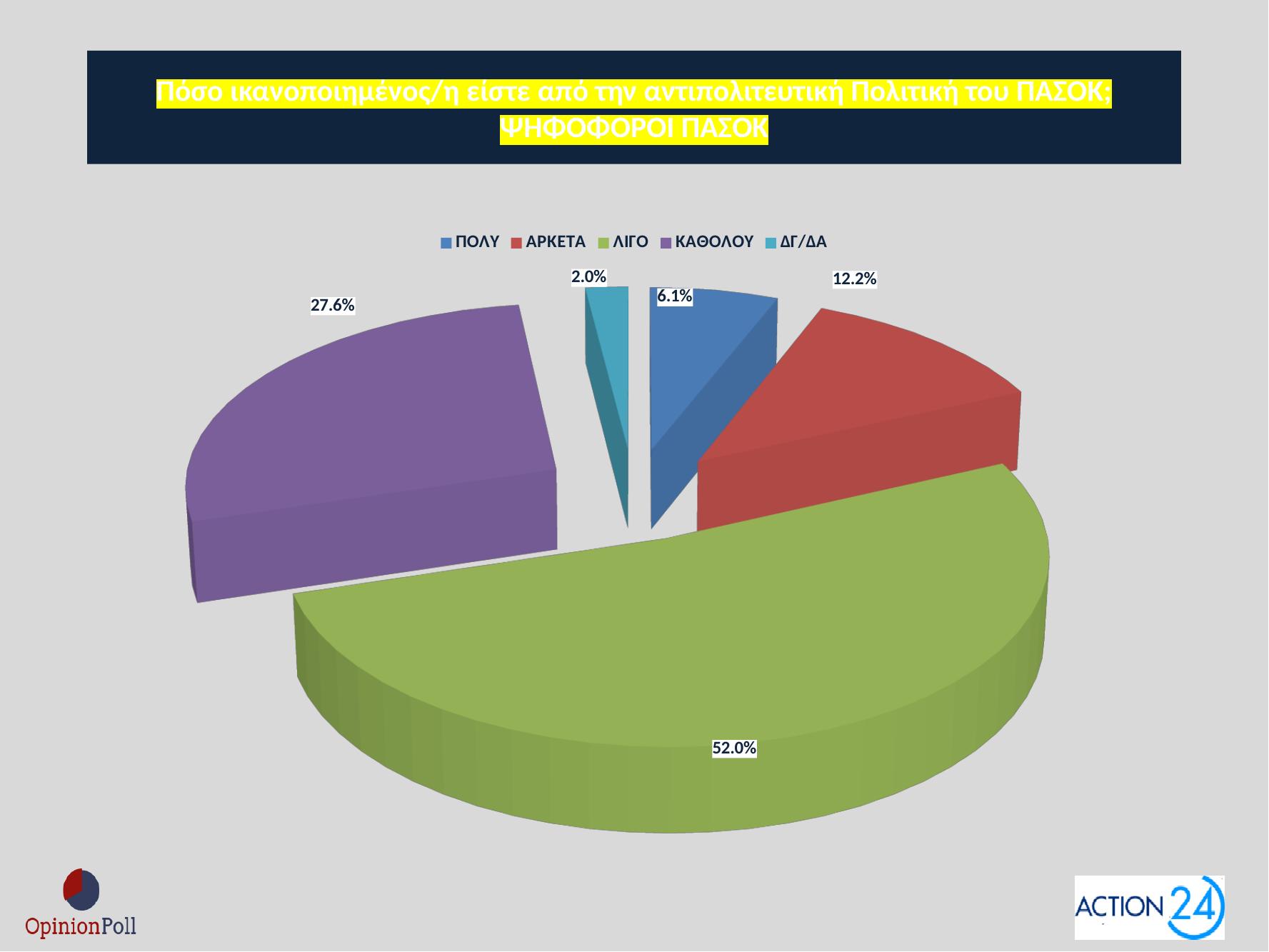
How many categories does the legend list? 5 What percentage of the pie is labelled ΛΙΓΟ? 52.0% Which category has the smallest slice of the pie? ΔΓ/ΔΑ What percentage of the pie is labelled ΔΓ/ΔΑ? 2.0% Which is larger, the ΑΡΚΕΤΑ slice or the ΠΟΛΥ slice? ΑΡΚΕΤΑ What kind of chart is shown on the slide? Pie chart What colour is the ΚΑΘΟΛΟΥ slice? Purple What percentage of the pie is labelled ΠΟΛΥ? 6.1% What percentage of the pie is labelled ΑΡΚΕΤΑ? 12.2% What is the difference in percentage points between ΛΙΓΟ and ΚΑΘΟΛΟΥ? 24.4 Which category has the largest slice of the pie? ΛΙΓΟ What percentage of the pie is labelled ΚΑΘΟΛΟΥ? 27.6%